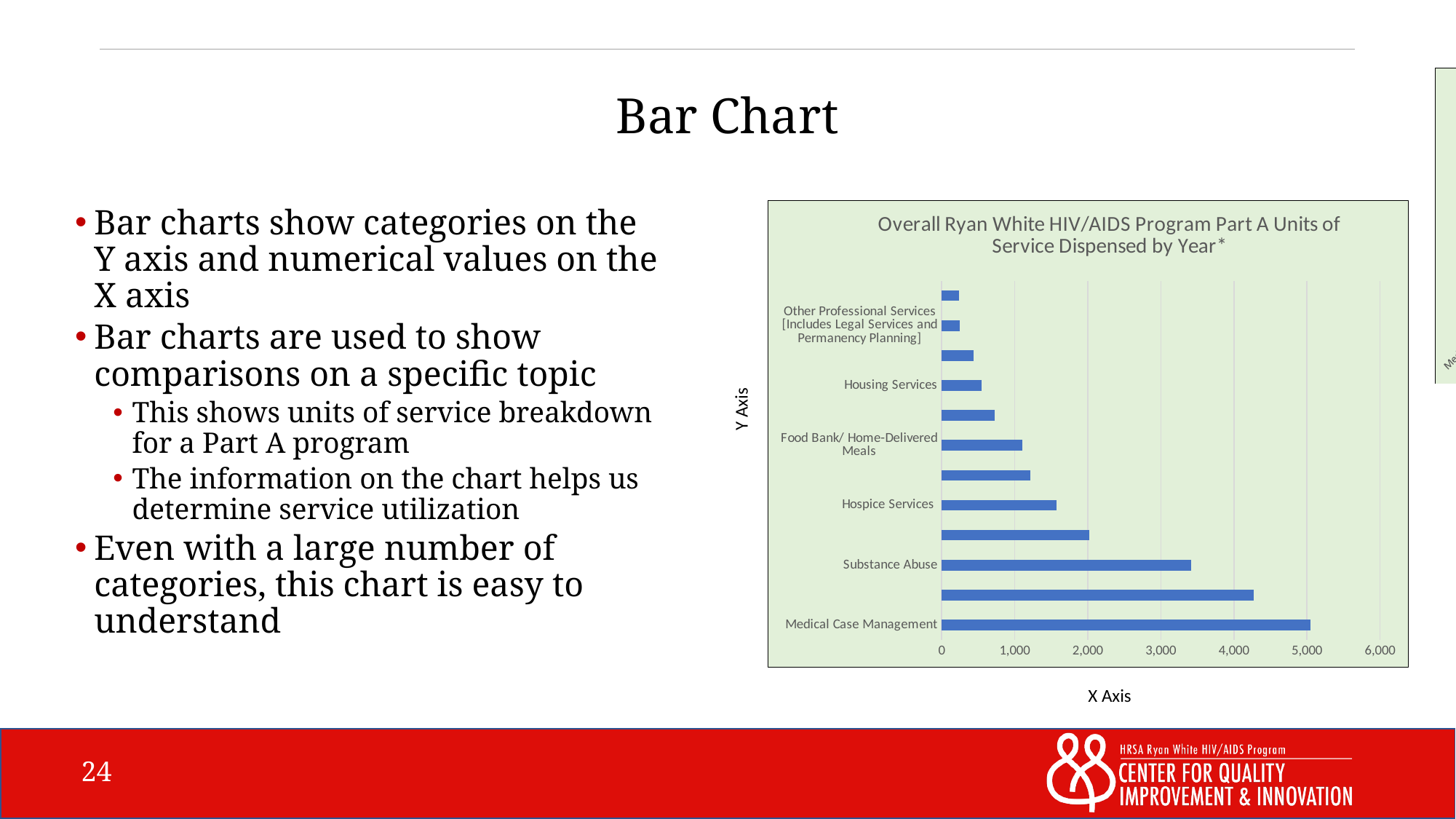
Is the value for Housing Services greater or less than 1,000? less How many bars are plotted in the chart? 12 Is the value for Medical Case Management greater or less than 4,000? greater Is the value for Food Bank/ Home-Delivered Meals greater or less than 2,000? less Which is larger, the value for Substance Abuse or the value for Hospice Services? Substance Abuse Which is larger, the value for Housing Services or the value for Food Bank/ Home-Delivered Meals? Food Bank/ Home-Delivered Meals What kind of chart is shown on the slide? Bar chart What is the title of the chart? Overall Ryan White HIV/AIDS Program Part A Units of Service Dispensed by Year* Which category has the longest bar in the chart? Medical Case Management